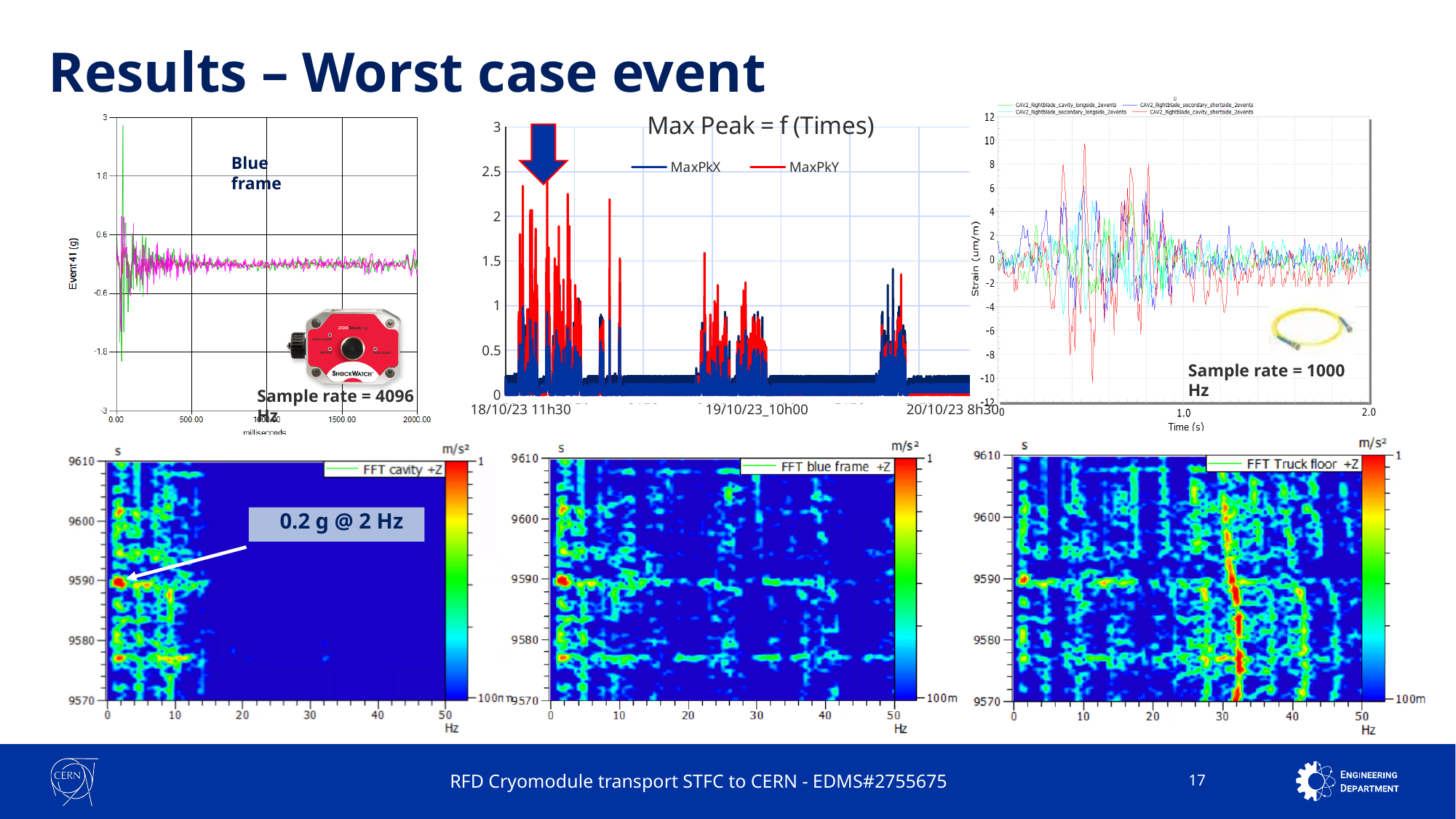
In the top-right strain chart, is the lowest value of the red trace greater or less than -8? less How many FFT spectrogram charts are shown along the bottom of the slide? 3 In the 'Max Peak = f (Times)' chart, how many series does the legend list? 2 In the 'Max Peak = f (Times)' chart, which series reaches the higher peak, MaxPkX or MaxPkY? MaxPkY What is the legend entry of the bottom-right spectrogram chart? FFT Truck floor +Z In the top-right strain chart, how many series does the legend list? 4 In the 'Max Peak = f (Times)' chart, is the highest MaxPkY peak greater or less than 2? greater What value does the annotation on the 'FFT cavity +Z' spectrogram point to? 0.2 g @ 2 Hz In the 'Max Peak = f (Times)' chart, is the highest MaxPkX peak greater or less than 2? less What kind of chart is the 'Max Peak = f (Times)' chart? line chart